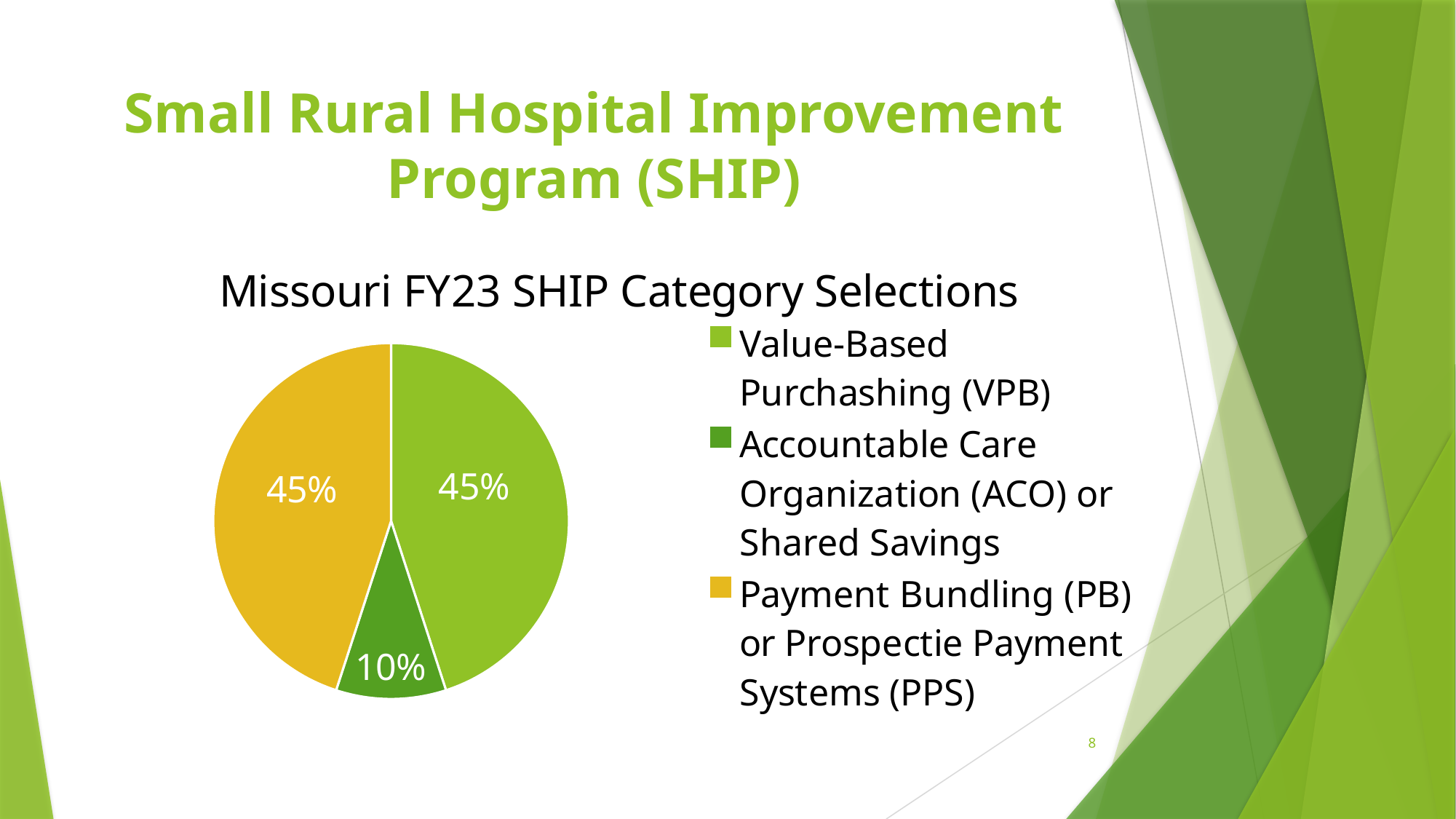
What type of chart is shown on the slide? pie chart What share of the pie is Payment Bundling (PB) or Prospectie Payment Systems (PPS)? 45% How many categories does the pie chart show? 3 Which category is shown in the gold/yellow slice? Payment Bundling (PB) or Prospectie Payment Systems (PPS) How many entries does the legend list? 3 Which category has the smallest slice of the pie? Accountable Care Organization (ACO) or Shared Savings What share of the pie is Accountable Care Organization (ACO) or Shared Savings? 10% What is the difference between the share for Value-Based Purchashing (VPB) and the share for Accountable Care Organization (ACO) or Shared Savings? 35% What share of the pie is Value-Based Purchashing (VPB)? 45% Which is larger, the share for Payment Bundling (PB) or Prospectie Payment Systems (PPS) or the share for Accountable Care Organization (ACO) or Shared Savings? Payment Bundling (PB) or Prospectie Payment Systems (PPS) What is the title of the chart? Missouri FY23 SHIP Category Selections What is the combined share of Value-Based Purchashing (VPB) and Payment Bundling (PB) or Prospectie Payment Systems (PPS)? 90%